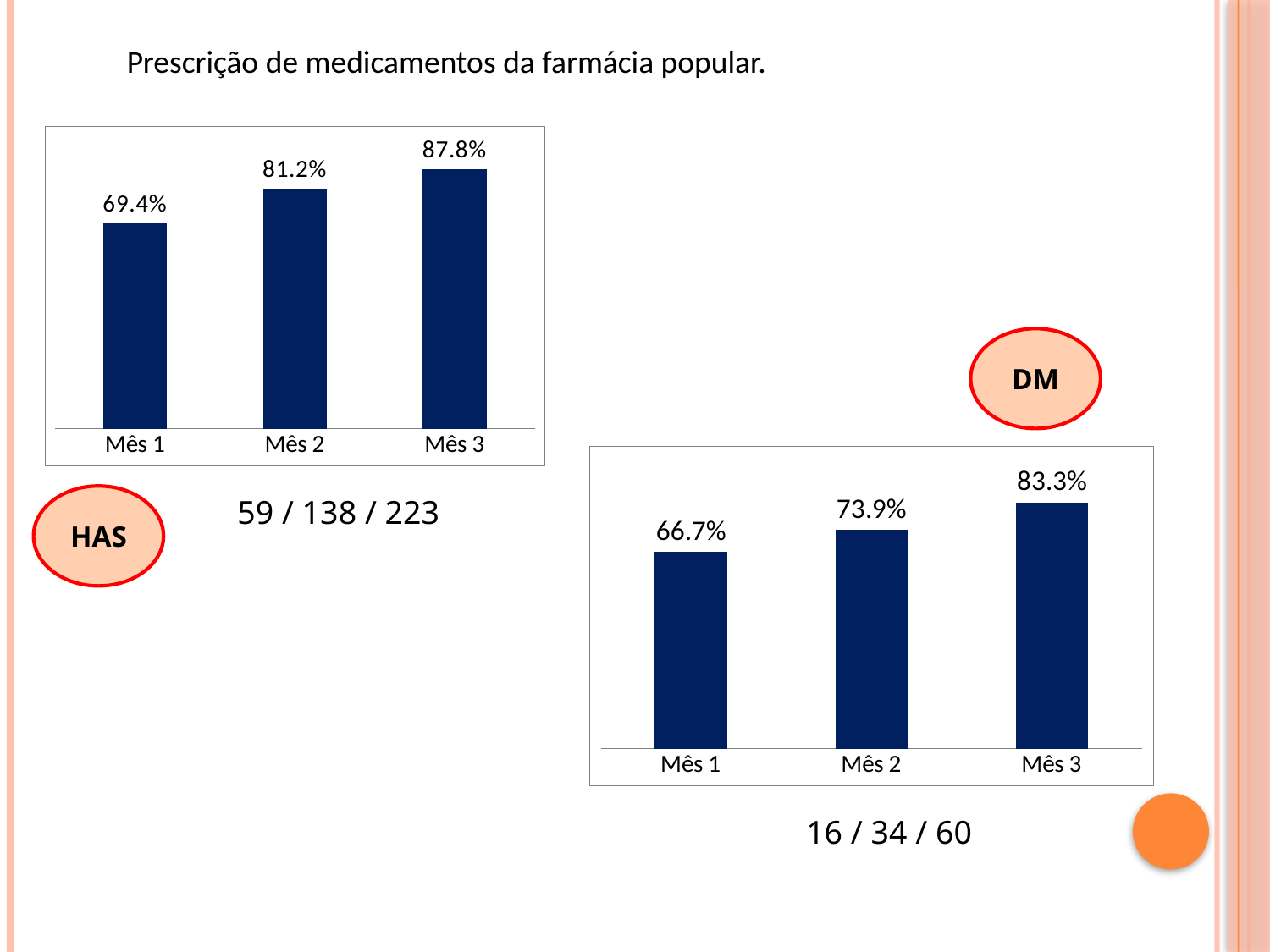
In the DM chart (bottom right), what is the value for Mês 2? 73.9% In the DM chart (bottom right), do the values rise or fall from Mês 1 to Mês 3? Rise In the DM chart (bottom right), what is the difference between the values for Mês 2 and Mês 1? 7.2% In the HAS chart (top left), what is the value for Mês 3? 87.8% Which is larger: the Mês 2 value in the HAS chart or the Mês 2 value in the DM chart? HAS chart (81.2%) In the DM chart (bottom right), what is the value for Mês 3? 83.3% In the HAS chart (top left), what is the value for Mês 1? 69.4% In the HAS chart (top left), what is the difference between the values for Mês 3 and Mês 1? 18.4% What type of chart is the HAS chart (top left)? Bar chart In the DM chart (bottom right), which month has the lowest value? Mês 1 How many bars are shown in the DM chart (bottom right)? 3 In the HAS chart (top left), which month has the highest value? Mês 3